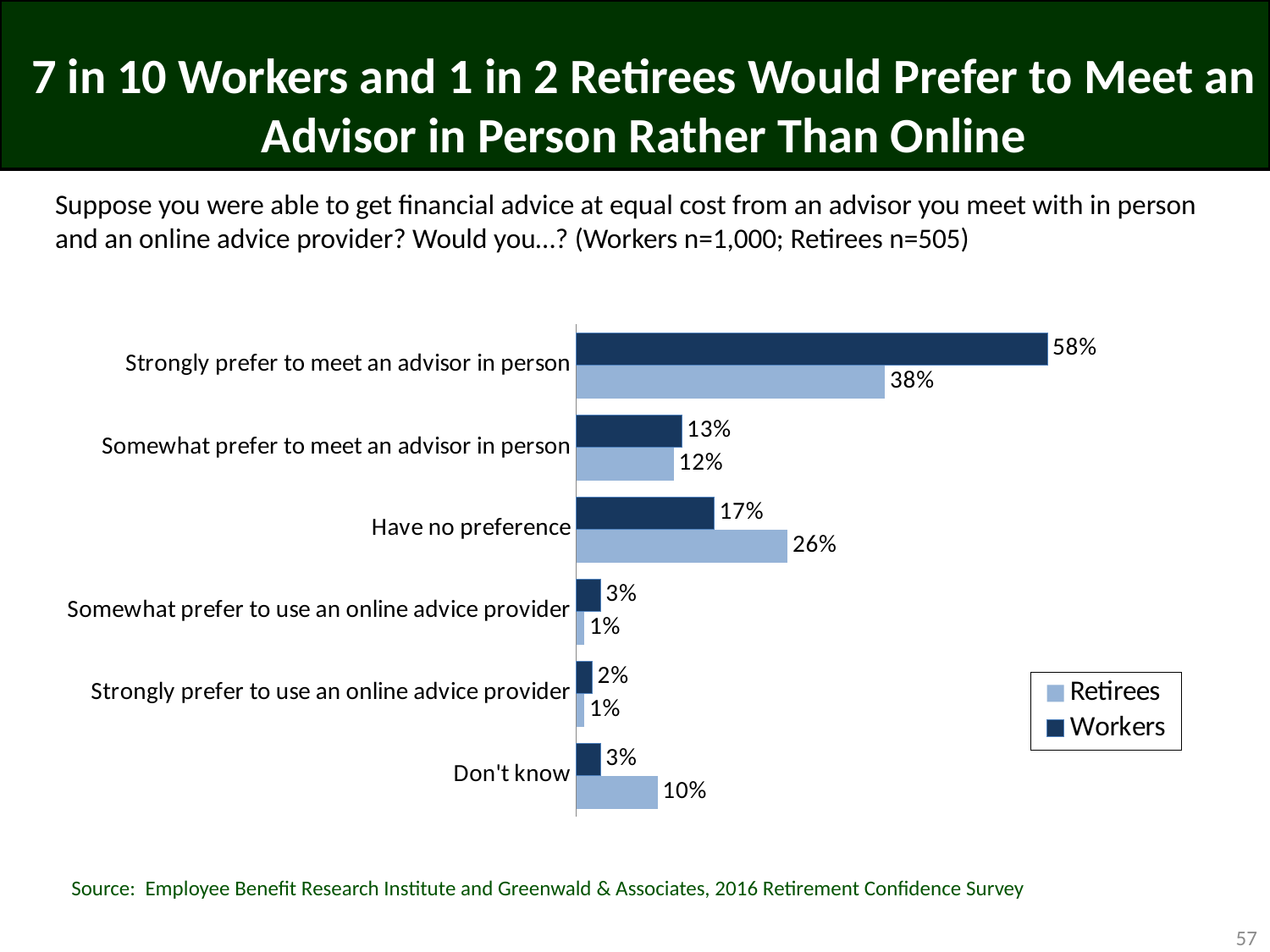
Which series is shown in the darker blue colour? Workers Which category has the highest value for Workers? Strongly prefer to meet an advisor in person For "Don't know", which group has the larger value, Workers or Retirees? Retirees Which category has the lowest value for Workers? Strongly prefer to use an online advice provider What percentage of Retirees have no preference? 26% What percentage of Retirees answered "Don't know"? 10% What is the difference between Workers and Retirees for "Strongly prefer to meet an advisor in person"? 20 percentage points What kind of chart is shown on the slide? Bar chart What percentage of Workers strongly prefer to meet an advisor in person? 58% How many response categories are shown on the chart? 6 For "Have no preference", which group has the larger value, Workers or Retirees? Retirees How many series does the legend list? 2